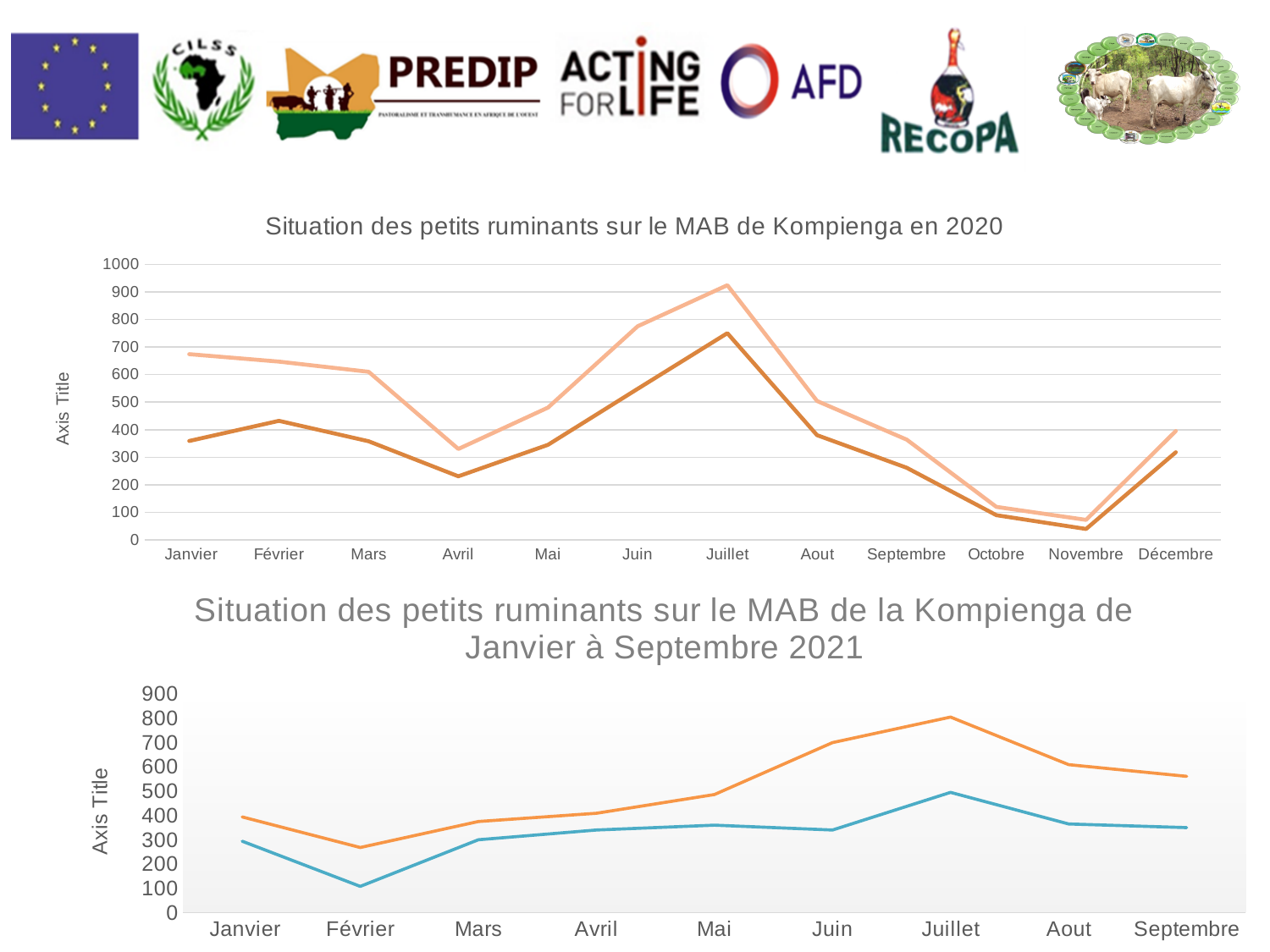
In the bottom chart (2021), which line is higher in Juin, the orange line or the blue line? the orange line What kind of chart is the top chart, 'Situation des petits ruminants sur le MAB de Kompienga en 2020'? Line chart In the top chart (2020), is the value of the darker orange line in Novembre greater or less than 100? less How many months are shown on the x axis of the top chart (2020)? 12 In the top chart (2020), do the values of both lines rise or fall from Juillet to Novembre? fall In the top chart (2020), is the value of the darker orange line in Juillet greater or less than 700? greater In the bottom chart (2021), in which month does the blue line reach its lowest value? Février In the top chart (2020), in which month does the darker orange line reach its lowest value? Novembre In the bottom chart (2021), is the value of the blue line in Février greater or less than 200? less In the top chart (2020), in which month does the lighter peach line reach its highest value? Juillet In the bottom chart (2021), in which month does the orange line reach its highest value? Juillet How many months are shown on the x axis of the bottom chart (Janvier à Septembre 2021)? 9